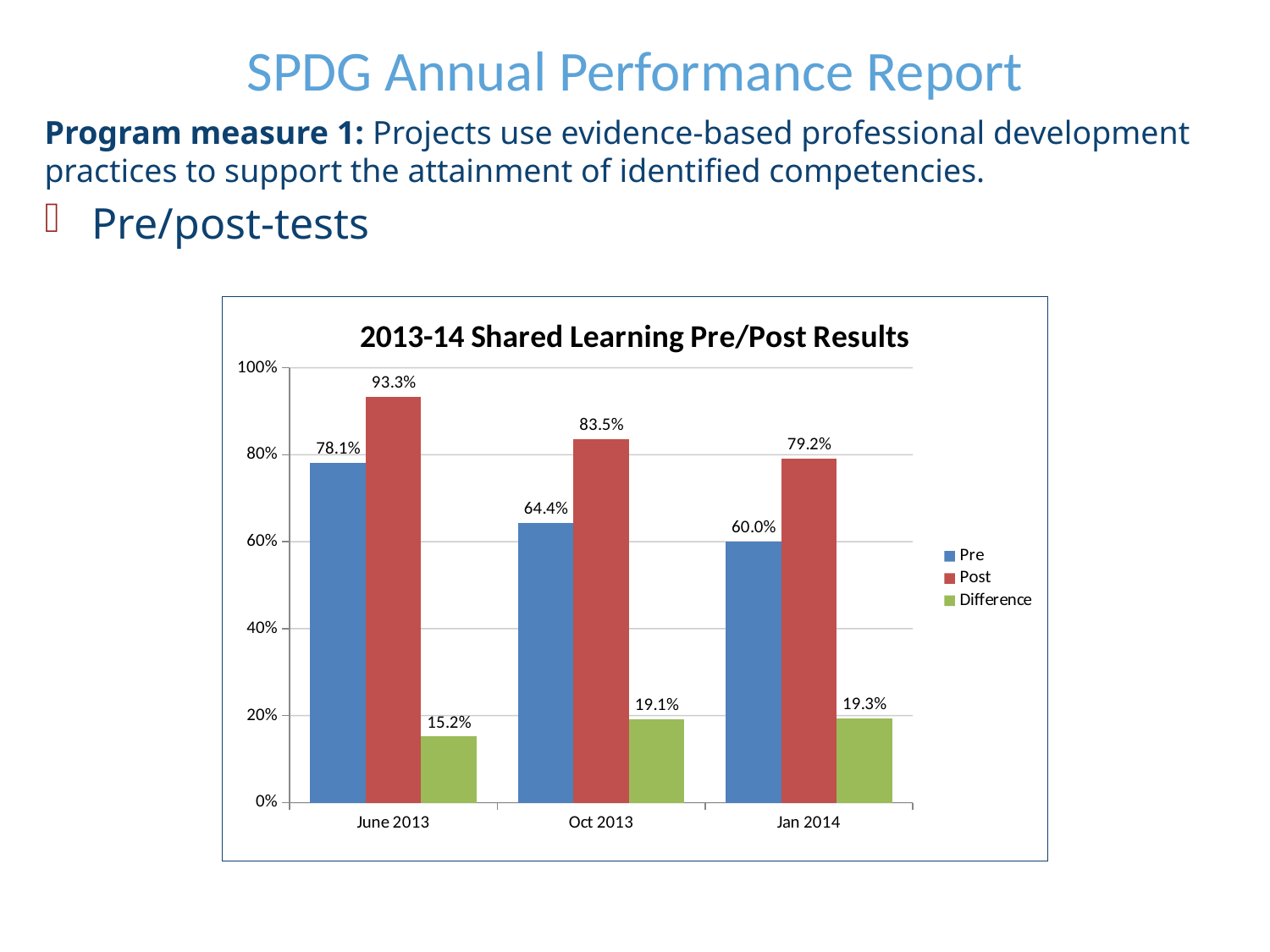
Which category has the lowest Pre value? Jan 2014 Which category has the highest Post value? June 2013 What is the difference between the Post and Pre values for Oct 2013? 19.1% How many series does the legend list? 3 Do the Pre values rise or fall from June 2013 to Jan 2014? fall What is the Post value for June 2013? 93.3% Which is larger, the Pre value for June 2013 or the Post value for Jan 2014? Pre value for June 2013 What kind of chart is shown? bar chart What is the Difference value for Jan 2014? 19.3% Is the Pre value for Jan 2014 greater or less than 80%? less What is the Pre value for Oct 2013? 64.4% How many categories are shown on the x axis? 3